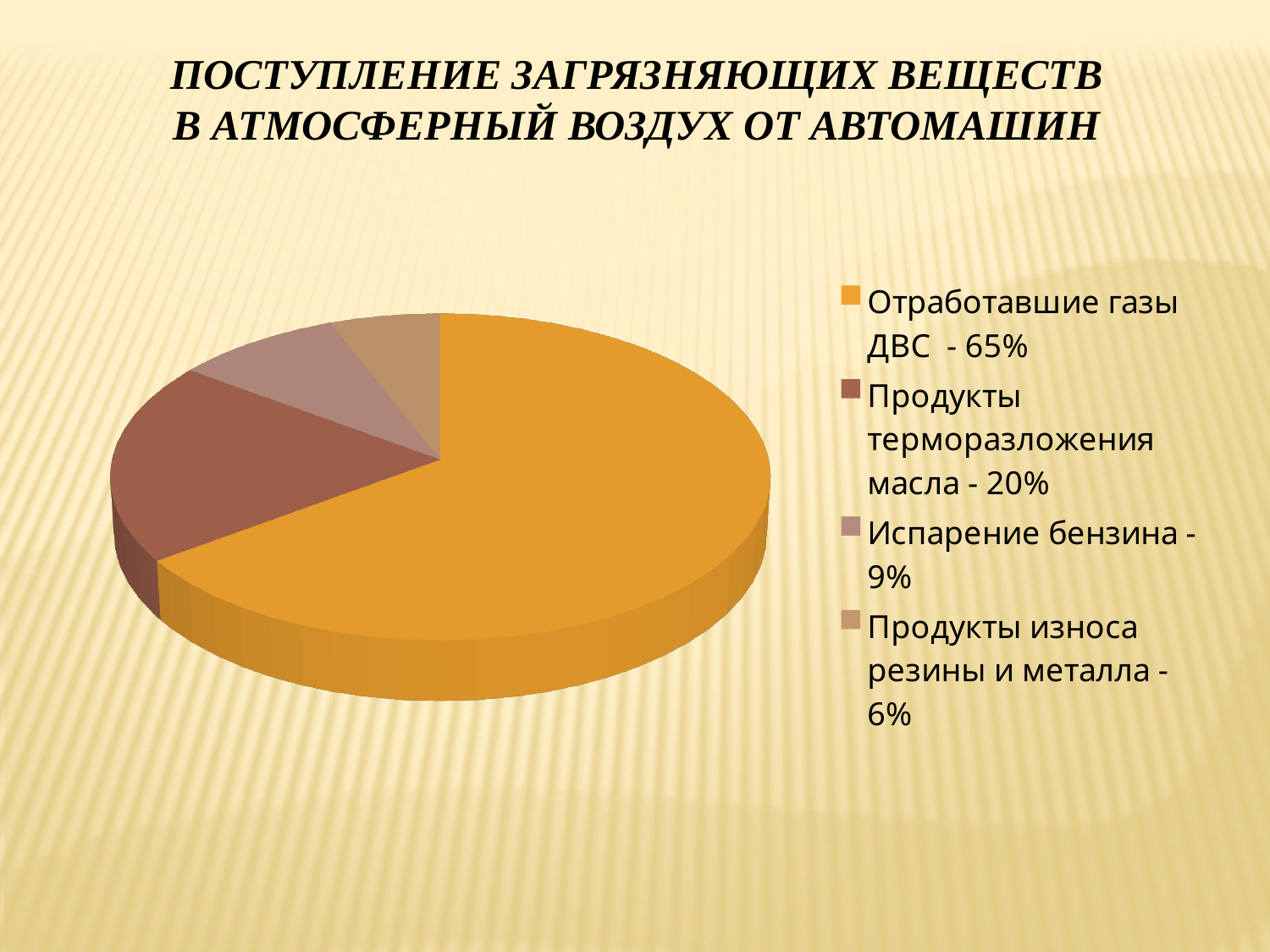
What percentage is shown for "Испарение бензина"? 9% What kind of chart is shown on the slide? Pie chart How many slices does the pie chart have? 4 What is the title of the chart on the slide? ПОСТУПЛЕНИЕ ЗАГРЯЗНЯЮЩИХ ВЕЩЕСТВ В АТМОСФЕРНЫЙ ВОЗДУХ ОТ АВТОМАШИН Which category has the largest share of the pie? Отработавшие газы ДВС What percentage is shown for "Продукты терморазложения масла"? 20% What is the difference in percentage points between "Отработавшие газы ДВС" and "Продукты терморазложения масла"? 45 What share of the pie is attributed to "Отработавшие газы ДВС"? 65% Which category has the smallest share of the pie? Продукты износа резины и металла Which is larger: the share for "Испарение бензина" or the share for "Продукты износа резины и металла"? Испарение бензина What percentage is shown for "Продукты износа резины и металла"? 6% What is the combined share of "Испарение бензина" and "Продукты износа резины и металла"? 15%